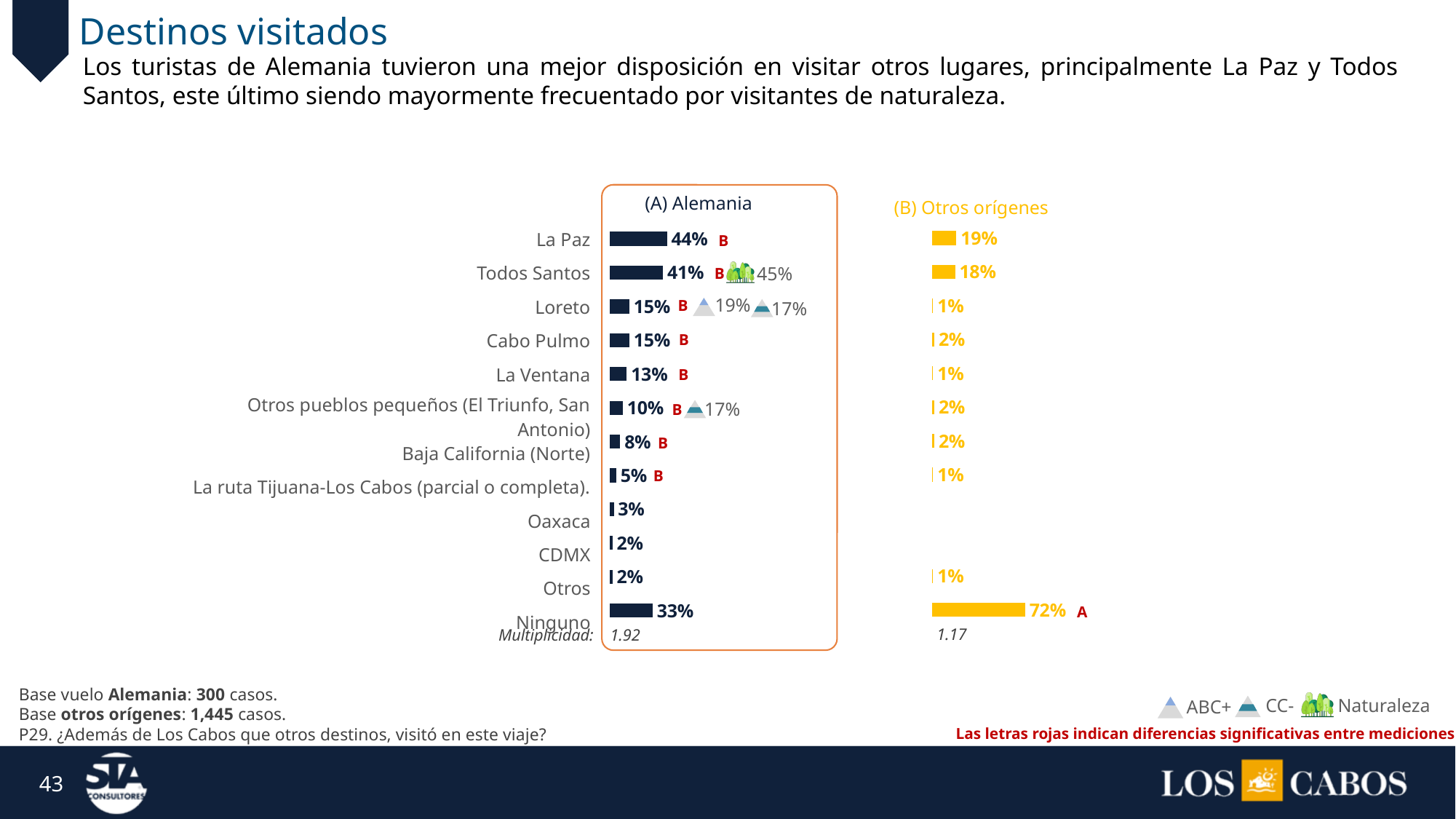
In the (A) Alemania chart, which is larger: the value for Loreto or the value for La Ventana? Loreto In the (A) Alemania chart, which destination has the highest value? La Paz In the (B) Otros orígenes chart, what percentage visited Todos Santos? 18% How many destination categories are listed on the chart? 12 In the (B) Otros orígenes chart, which category has the highest value? Ninguno What is the difference between the La Paz values in the (A) Alemania chart and the (B) Otros orígenes chart? 25% In the (A) Alemania chart, what percentage visited La Paz? 44% In the (A) Alemania chart, what is the value for Ninguno? 33% What kind of chart is used on this slide? Bar chart What is the Multiplicidad value shown for (A) Alemania? 1.92 In the (A) Alemania chart, what is the difference between the values for La Paz and Todos Santos? 3% In the (B) Otros orígenes chart, what is the value for Ninguno? 72%